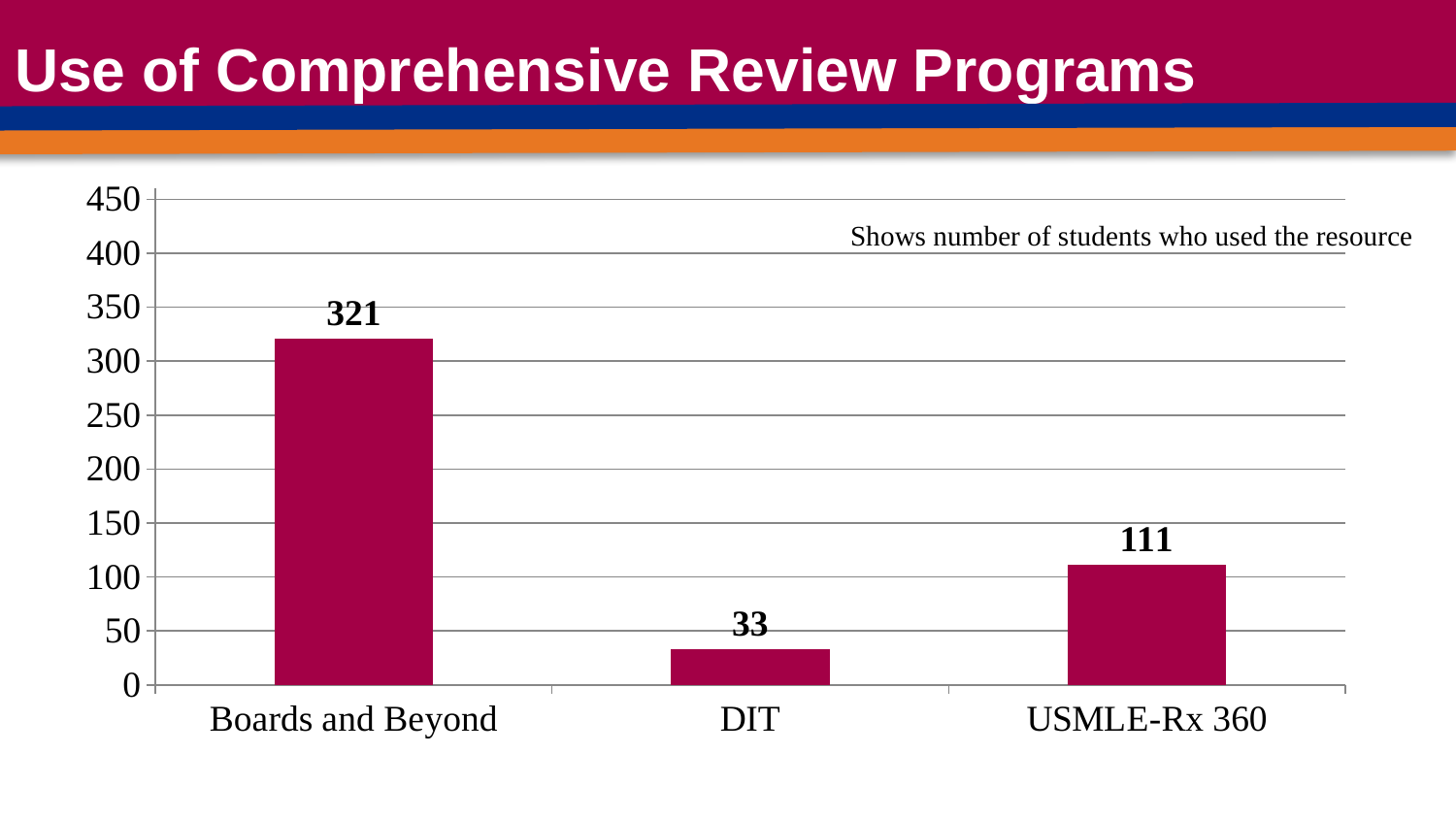
Which resource was used by the most students? Boards and Beyond How many students used USMLE-Rx 360? 111 Is the value for Boards and Beyond greater or less than 300? greater What is the difference between the number of students who used USMLE-Rx 360 and the number who used DIT? 78 Which was used by more students, DIT or USMLE-Rx 360? USMLE-Rx 360 How many students used Boards and Beyond? 321 What kind of chart is shown on the slide? bar chart How many students used DIT? 33 Which resource was used by the fewest students? DIT What is the difference between the number of students who used Boards and Beyond and the number who used USMLE-Rx 360? 210 How many resources are shown on the chart? 3 What is the title of the slide? Use of Comprehensive Review Programs